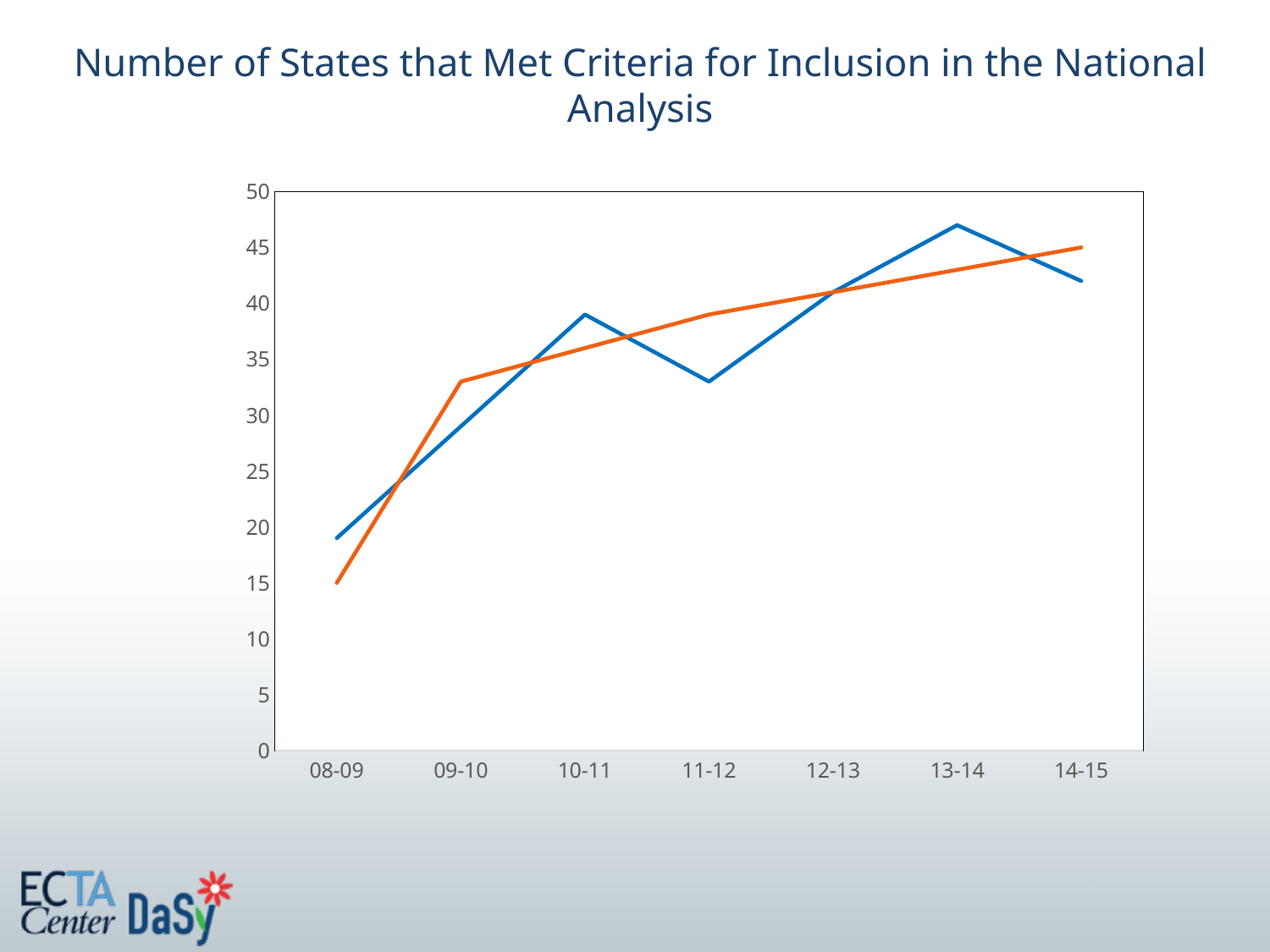
Is the value of the blue line for 11-12 greater or less than 35? less At 11-12, which line has the higher value, the blue line or the orange line? the orange line How many lines are plotted on the chart? 2 In which year does the blue line reach its highest value? 13-14 Is the value of the blue line for 08-09 greater or less than 15? greater What is the title of the chart? Number of States that Met Criteria for Inclusion in the National Analysis Does the orange line rise or fall from 08-09 to 14-15? rise Is the value of the blue line for 13-14 greater or less than 45? greater In which year does the orange line have its lowest value? 08-09 How many year categories are shown on the x axis? 7 What kind of chart is shown on the slide? line chart